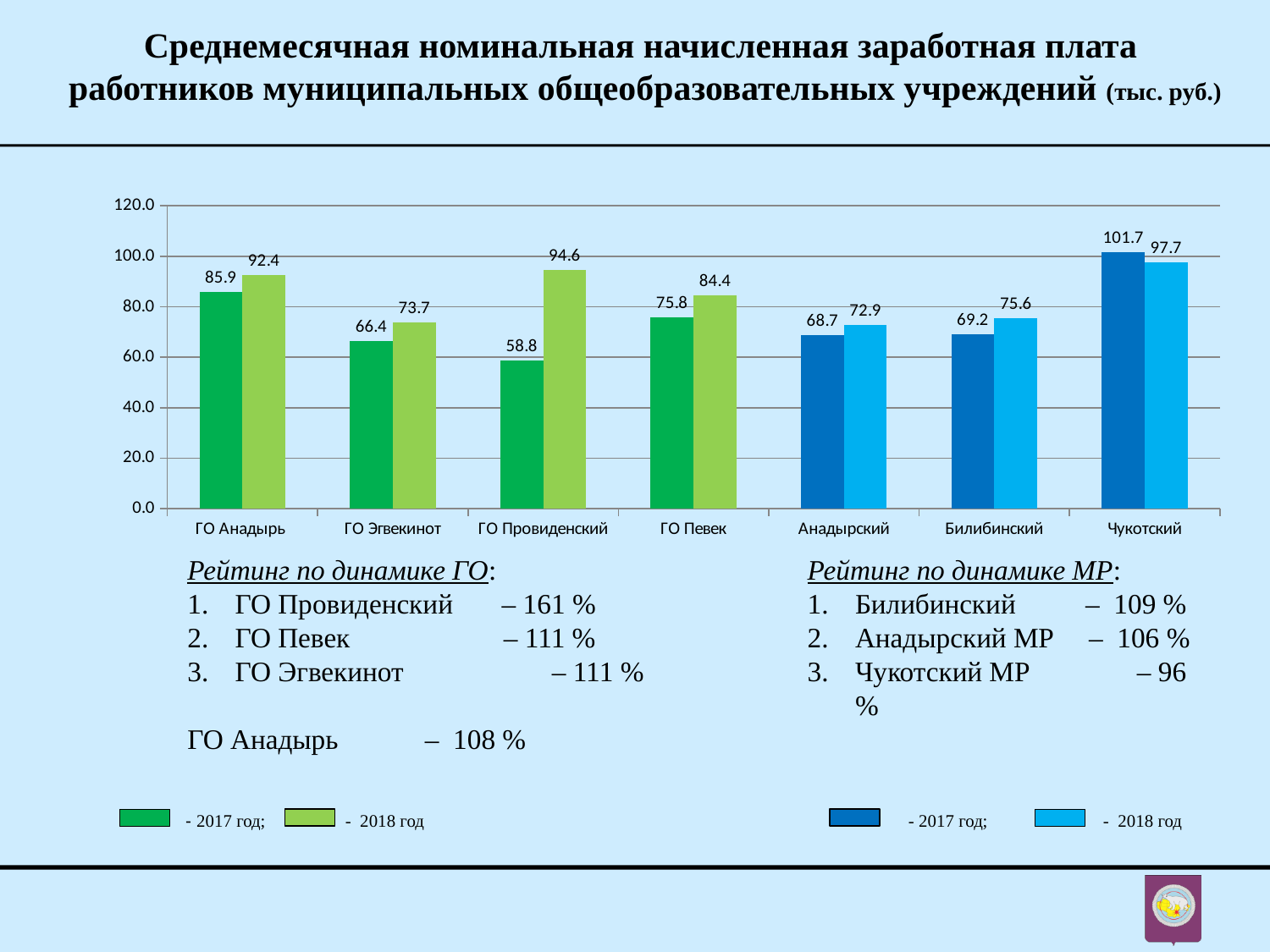
Which category has the lowest 2018 value? Анадырский What kind of chart is shown on the slide? bar chart How many categories are shown on the x axis? 7 Is the 2017 value for ГО Певек greater or less than 80.0? less Which is larger for Чукотский: the 2017 value or the 2018 value? 2017 value Which category has the highest 2017 value? Чукотский What is the 2018 value for ГО Провиденский? 94.6 What is the 2018 value for Билибинский? 75.6 Which category has the lowest 2017 value? ГО Провиденский Which two years does the legend list for each group of bars? 2017 год and 2018 год What is the 2017 value for ГО Анадырь? 85.9 What is the difference between the 2018 and 2017 values for ГО Провиденский? 35.8